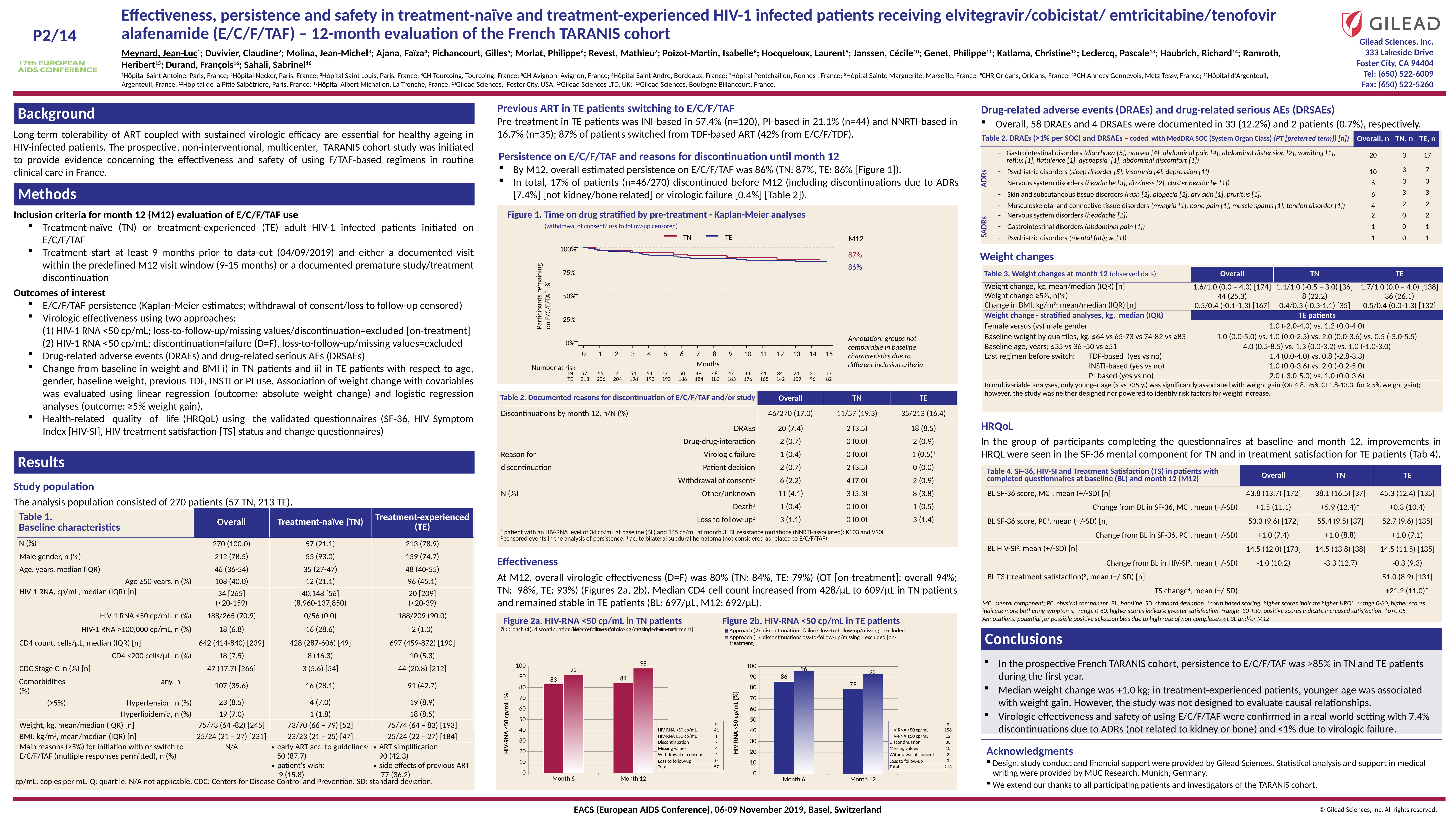
In Figure 2a (HIV-RNA <50 cp/mL in TN patients), what is the difference between the Approach (1) and Approach (2) values at Month 12? 14 What kind of chart is Figure 1 (Time on drug stratified by pre-treatment)? Line chart In Figure 2b (HIV-RNA <50 cp/mL in TE patients), which is larger: the Approach (2) value at Month 6 or at Month 12? Month 6 In Figure 2a (HIV-RNA <50 cp/mL in TN patients), what is the value for Approach (1) at Month 12? 98 In Figure 1 (Time on drug stratified by pre-treatment), what is the M12 value for the TN group? 87% In Figure 2a (HIV-RNA <50 cp/mL in TN patients), how many series does the legend list? 2 In Figure 2b (HIV-RNA <50 cp/mL in TE patients), which bar has the lowest value? Approach (2) at Month 12 In Figure 2b (HIV-RNA <50 cp/mL in TE patients), what is the value for Approach (2) at Month 12? 79 What kind of chart is Figure 2b (HIV-RNA <50 cp/mL in TE patients)? Bar chart In Figure 2a (HIV-RNA <50 cp/mL in TN patients), what is the value for Approach (2) at Month 6? 83 In Figure 2b (HIV-RNA <50 cp/mL in TE patients), what is the value for Approach (1) at Month 6? 96 In Figure 1 (Time on drug stratified by pre-treatment), what is the M12 value for the TE group? 86%